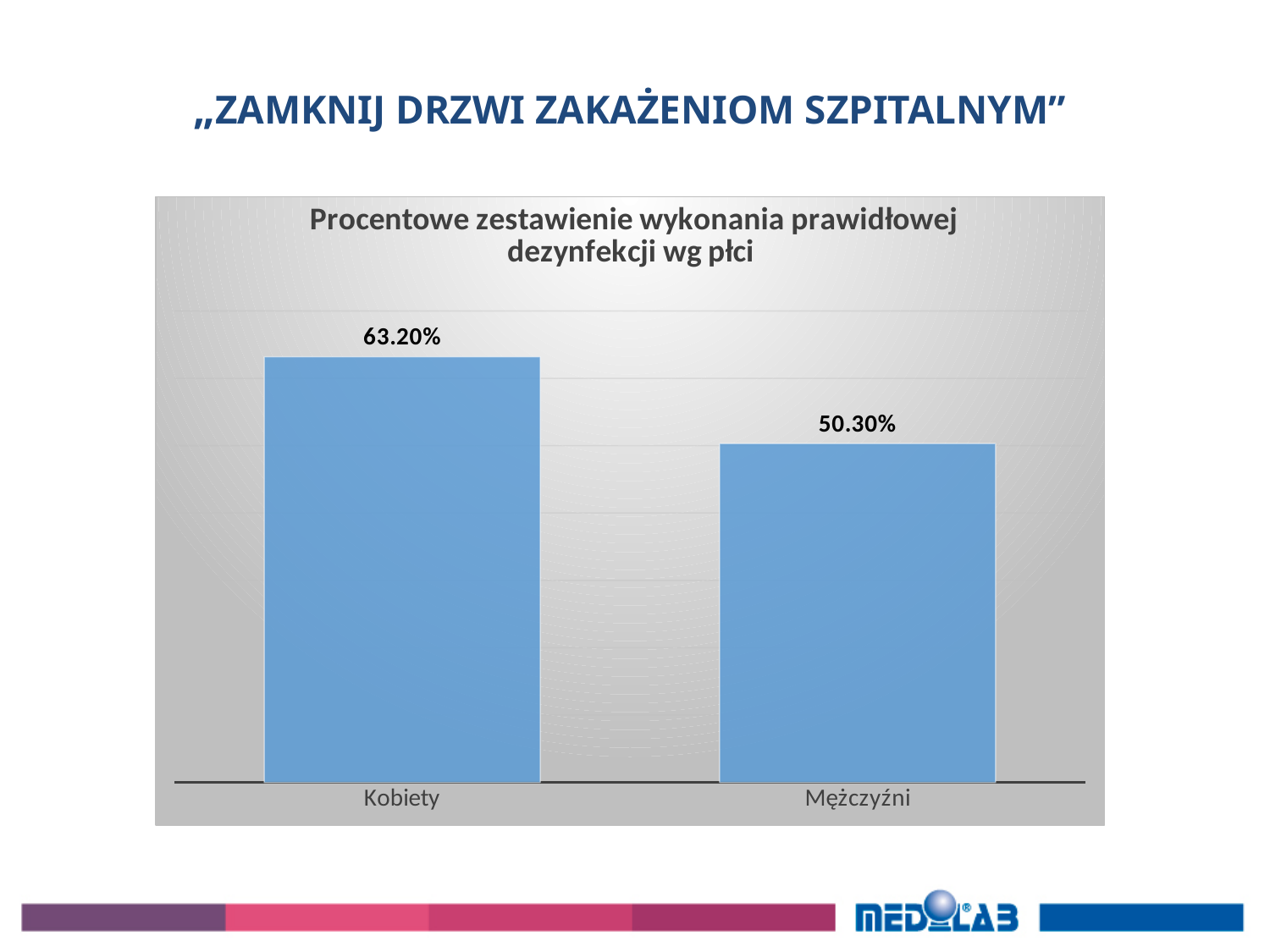
What is the value for Mężczyźni? 50.30% What colour are the bars in the chart? Blue Which category has the lowest value? Mężczyźni Which is larger, the value for Kobiety or the value for Mężczyźni? Kobiety How many categories are shown in the chart? 2 What is the difference between the values for Kobiety and Mężczyźni? 12.90% What kind of chart is shown on the slide? Bar chart What is the value for Kobiety? 63.20% Which category has the highest value? Kobiety What is the title of the chart? Procentowe zestawienie wykonania prawidłowej dezynfekcji wg płci